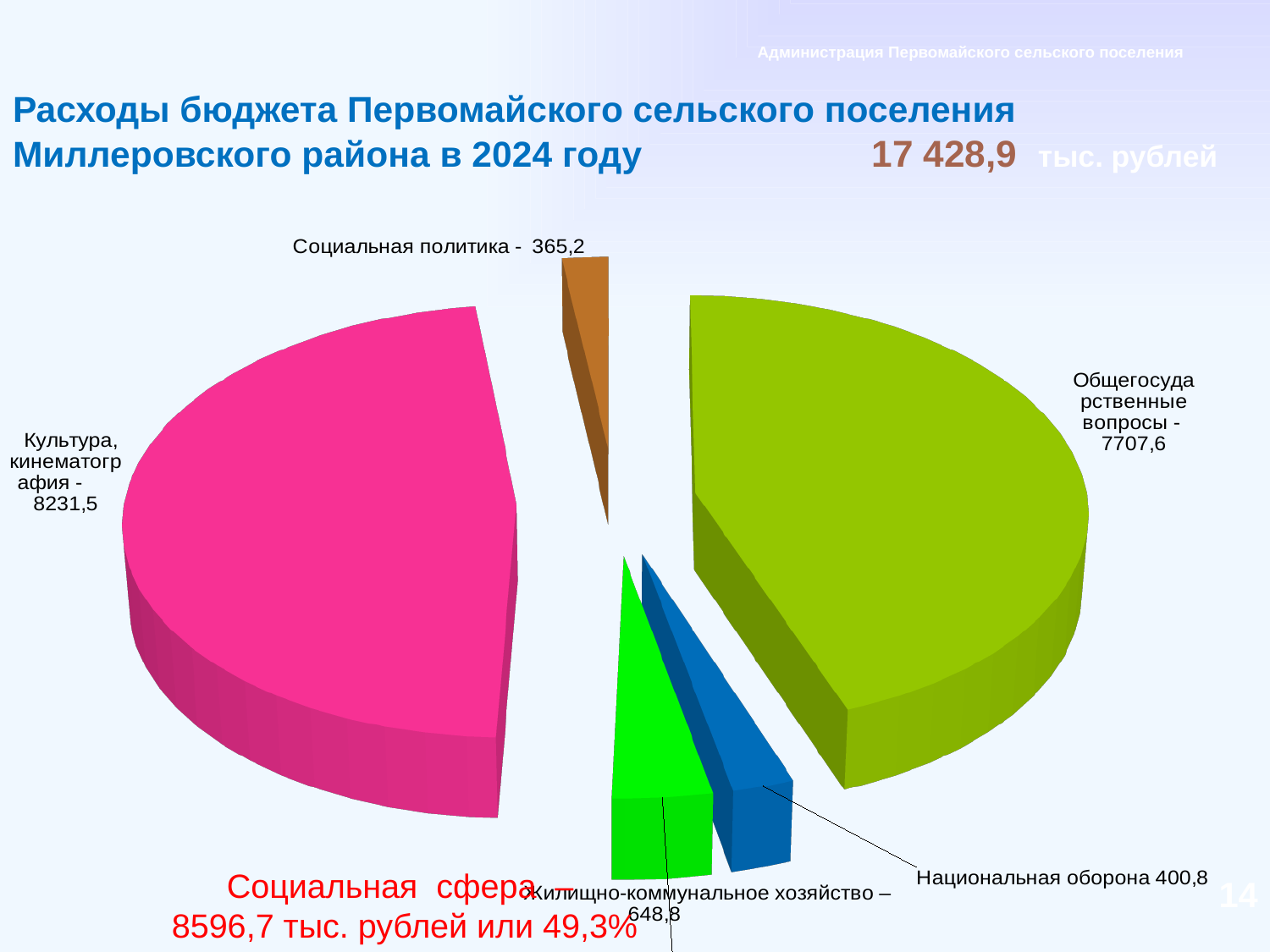
Which category has the largest value in the pie chart? Культура, кинематография Which is larger: Жилищно-коммунальное хозяйство or Национальная оборона? Жилищно-коммунальное хозяйство Which category has the smallest value in the pie chart? Социальная политика What kind of chart is shown on the slide? Pie chart What total budget expenditure figure is shown in the slide heading? 17 428,9 тыс. рублей What is the value for Общегосударственные вопросы? 7707,6 What is the value for Социальная политика? 365,2 What is the value for Культура, кинематография? 8231,5 What is the difference between the values for Культура, кинематография and Общегосударственные вопросы? 523,9 How many slices does the pie chart have? 5 What is the value for Жилищно-коммунальное хозяйство? 648,8 What is the value for Национальная оборона? 400,8